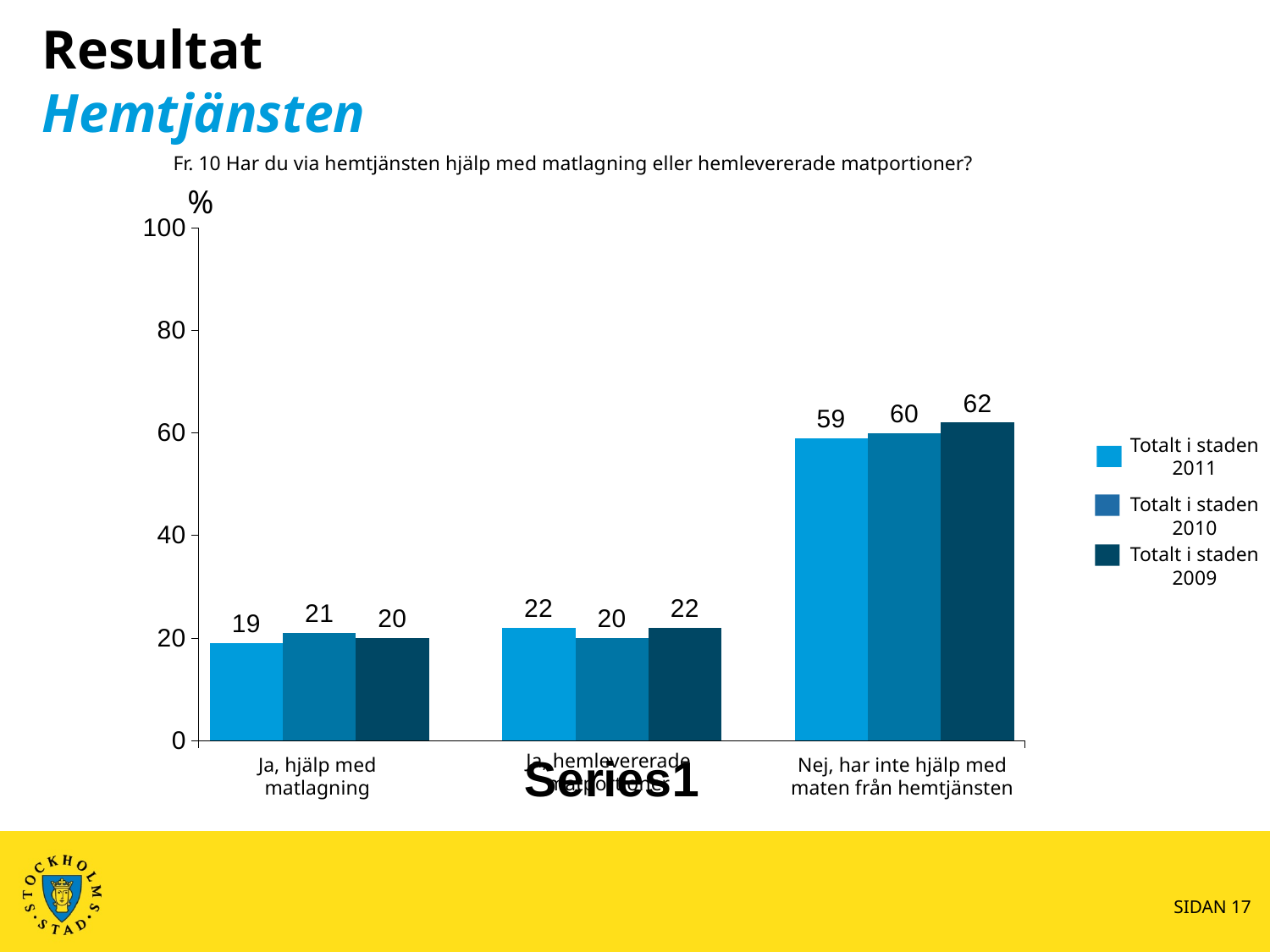
What kind of chart is shown on the slide? bar chart What is the value for 'Totalt i staden 2010' in the middle category (Ja, hemlevererade matportioner)? 20 Which category has the highest values across all three series? Nej, har inte hjälp med maten från hemtjänsten What is the value for 'Totalt i staden 2009' in the category 'Nej, har inte hjälp med maten från hemtjänsten'? 62 How many categories are shown on the x axis? 3 How many series does the legend list? 3 Which series has the lowest value in the category 'Ja, hjälp med matlagning'? Totalt i staden 2011 What is the difference between the 'Totalt i staden 2009' and 'Totalt i staden 2011' values in the category 'Nej, har inte hjälp med maten från hemtjänsten'? 3 What unit is shown at the top of the y axis? % In the category 'Ja, hjälp med matlagning', which is larger: the value for 'Totalt i staden 2010' or 'Totalt i staden 2009'? Totalt i staden 2010 Is the value for 'Totalt i staden 2010' in the category 'Nej, har inte hjälp med maten från hemtjänsten' greater or less than 40? greater What is the value for 'Totalt i staden 2011' in the category 'Ja, hjälp med matlagning'? 19